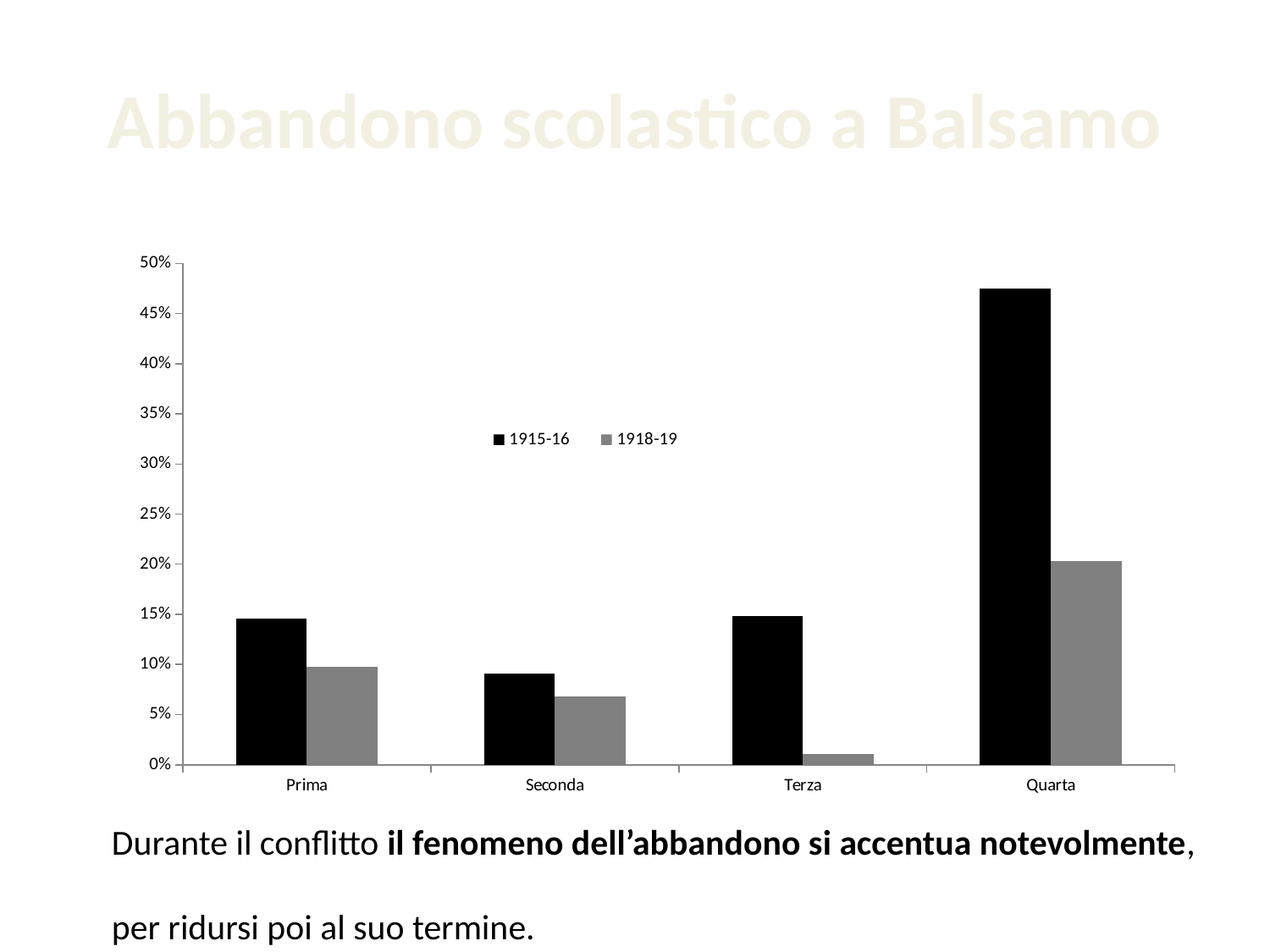
Which category has the lowest value for the 1918-19 series? Terza Is the value for Terza in the 1918-19 series greater or less than 5%? less Is the value for Quarta in the 1915-16 series greater or less than 45%? greater How many categories are shown on the x axis? 4 Which category has the highest value for the 1918-19 series? Quarta For Quarta, which series has the larger value, 1915-16 or 1918-19? 1915-16 Which category has the highest value for the 1915-16 series? Quarta What are the two series named in the legend? 1915-16 and 1918-19 Is the value for Seconda in the 1915-16 series greater or less than 10%? less Which category has the lowest value for the 1915-16 series? Seconda How many series does the legend list? 2 What kind of chart is shown on the slide? bar chart